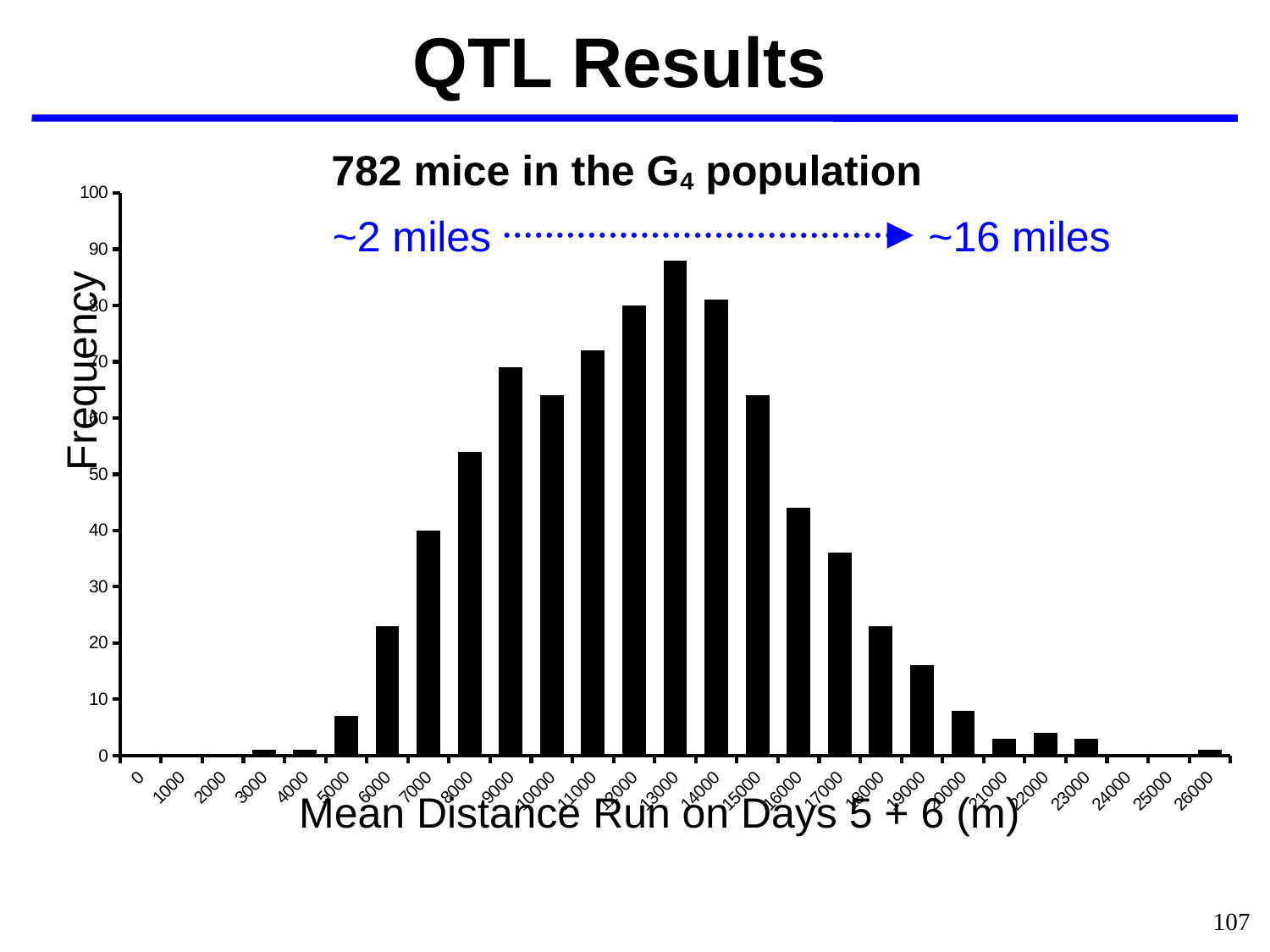
Which x-axis category has the highest frequency? 13000 What is the label of the x axis? Mean Distance Run on Days 5 + 6 (m) What kind of chart is shown on the slide? bar chart Which has the higher frequency, 8000 or 17000? 8000 Is the frequency for 19000 greater or less than 20? less How many categories are labelled on the x axis? 27 Is the frequency for 13000 greater or less than 80? greater Which has the higher frequency, 12000 or 16000? 12000 Is the frequency for 9000 greater or less than 60? greater What is the label of the y axis? Frequency Do the frequencies rise or fall from 13000 to 20000 along the x axis? fall